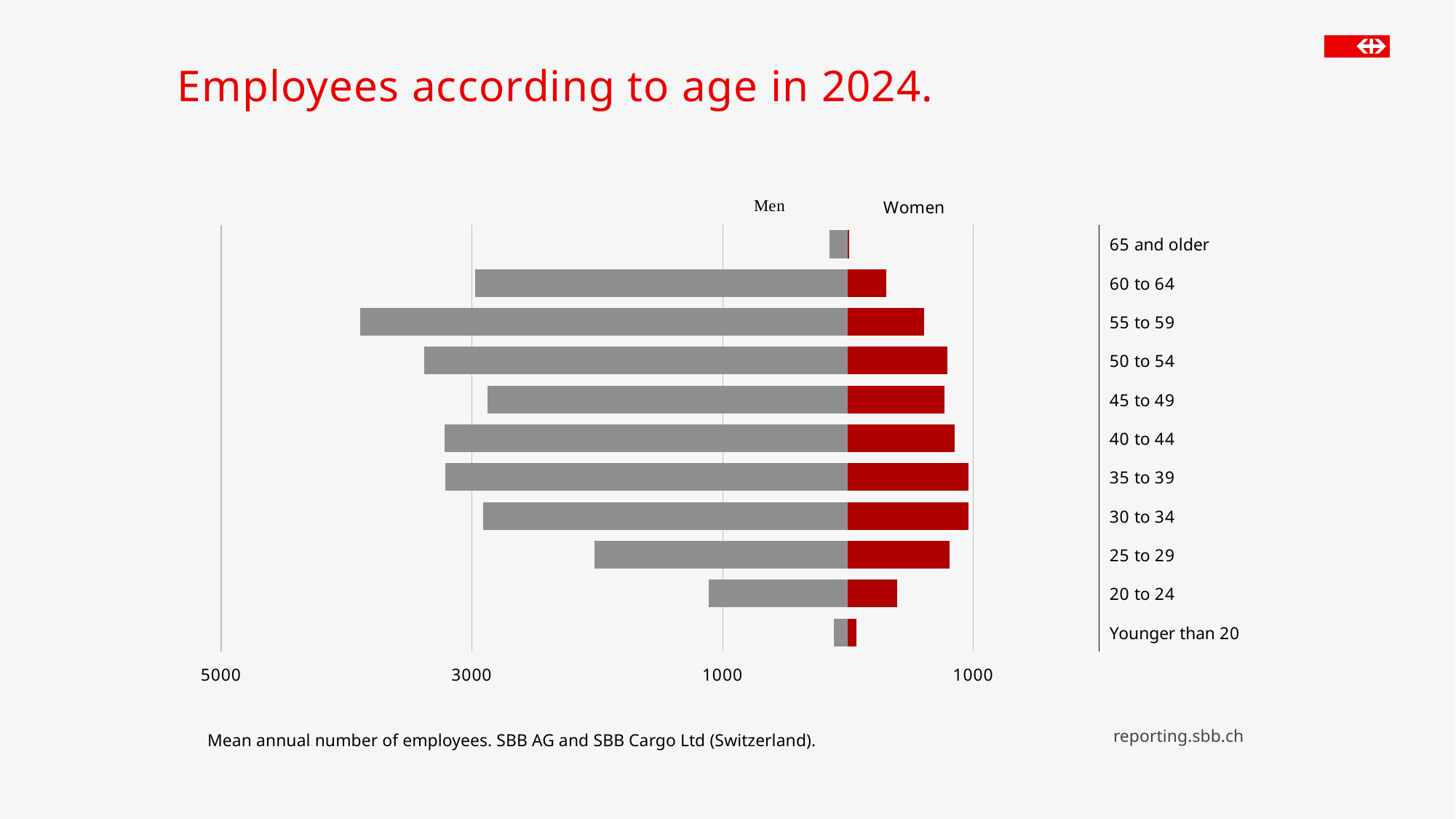
Is the number of men aged 25 to 29 greater or less than 3000? less Is the number of men aged 55 to 59 greater or less than 3000? greater What colour are the bars for women? Red Which age group has the lowest number of women? 65 and older Is the number of women aged 60 to 64 greater or less than 1000? less How many series does the chart show? 2 What kind of chart is shown on the slide? Bar chart Which age group has more women, 55 to 59 or 60 to 64? 55 to 59 Which age group has more men, 55 to 59 or 50 to 54? 55 to 59 How many age groups are shown in the chart? 11 Which age group has the highest number of men? 55 to 59